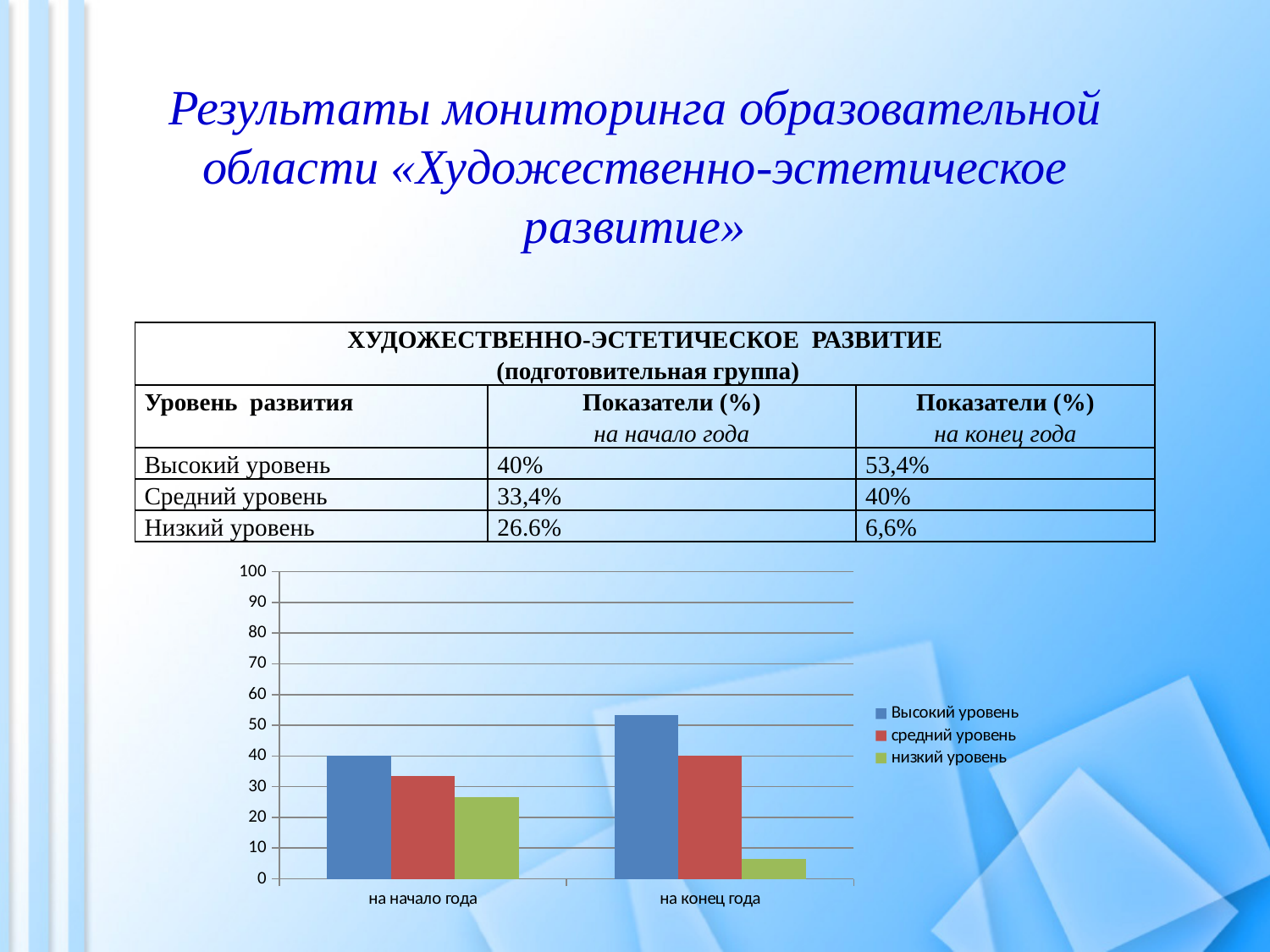
Is the value for Высокий уровень at на конец года greater or less than 50? greater What kind of chart is shown on the slide? bar chart Which series has the lowest bar at на конец года? низкий уровень Does the value for Высокий уровень rise or fall from на начало года to на конец года? rise What is the value for Высокий уровень at на начало года? 40% Is the value for низкий уровень at на конец года greater or less than 10? less How many series does the chart legend list? 3 What is the value for Высокий уровень at на конец года? 53,4% What is the value for низкий уровень at на конец года? 6,6% What is the value for средний уровень at на конец года? 40% How many categories are shown on the x axis of the chart? 2 Which series has the highest bar at на конец года? Высокий уровень